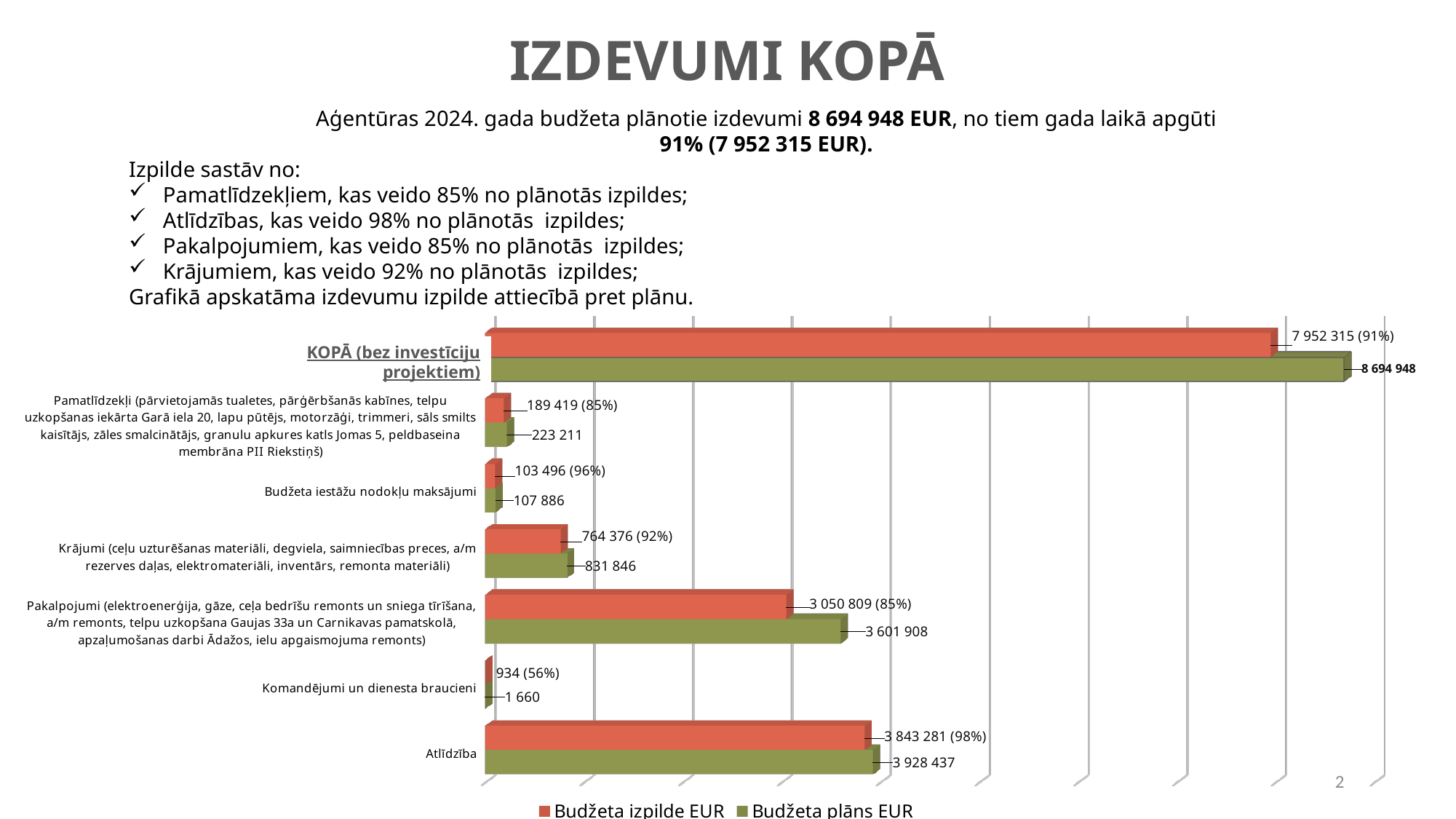
What is the Budžeta izpilde EUR value for Atlīdzība? 3 843 281 (98%) What is the Budžeta plāns EUR value for KOPĀ (bez investīciju projektiem)? 8 694 948 What type of chart is shown on the slide? bar chart How many categories are plotted on the chart? 7 Which category has the lowest Budžeta plāns EUR value? Komandējumi un dienesta braucieni Excluding the KOPĀ total, which category has the highest Budžeta izpilde EUR value? Atlīdzība What colour are the Budžeta plāns EUR bars? green Which is larger for Krājumi: the Budžeta izpilde EUR value or the Budžeta plāns EUR value? Budžeta plāns EUR What is the Budžeta izpilde EUR value for Komandējumi un dienesta braucieni? 934 (56%) How many series does the chart legend list? 2 What is the Budžeta plāns EUR value for Pakalpojumi? 3 601 908 What is the difference between the Budžeta plāns EUR and Budžeta izpilde EUR values for Pakalpojumi? 551 099